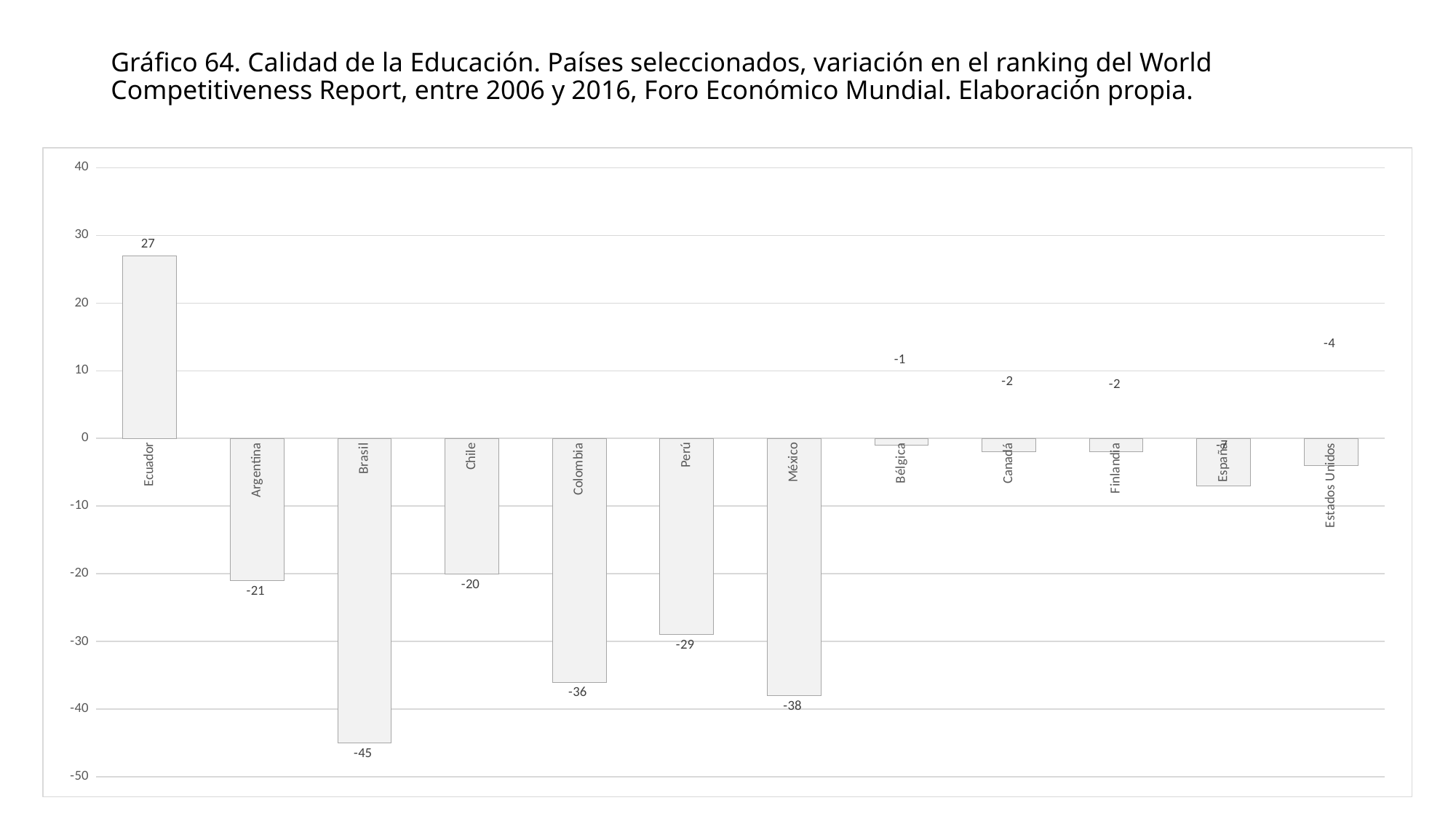
What is the difference between the values for Colombia and Perú? 7 Which country has the highest value? Ecuador How many countries are shown on the chart? 12 What is the value for Ecuador? 27 Is the value for España greater or less than -10? greater Which two countries share the value -2? Canadá and Finlandia Which country has the lowest value? Brasil What kind of chart is shown on the slide? Bar chart What is the value for México? -38 What is the value for Estados Unidos? -4 What is the value for Brasil? -45 Which has a larger value, Argentina or Chile? Chile